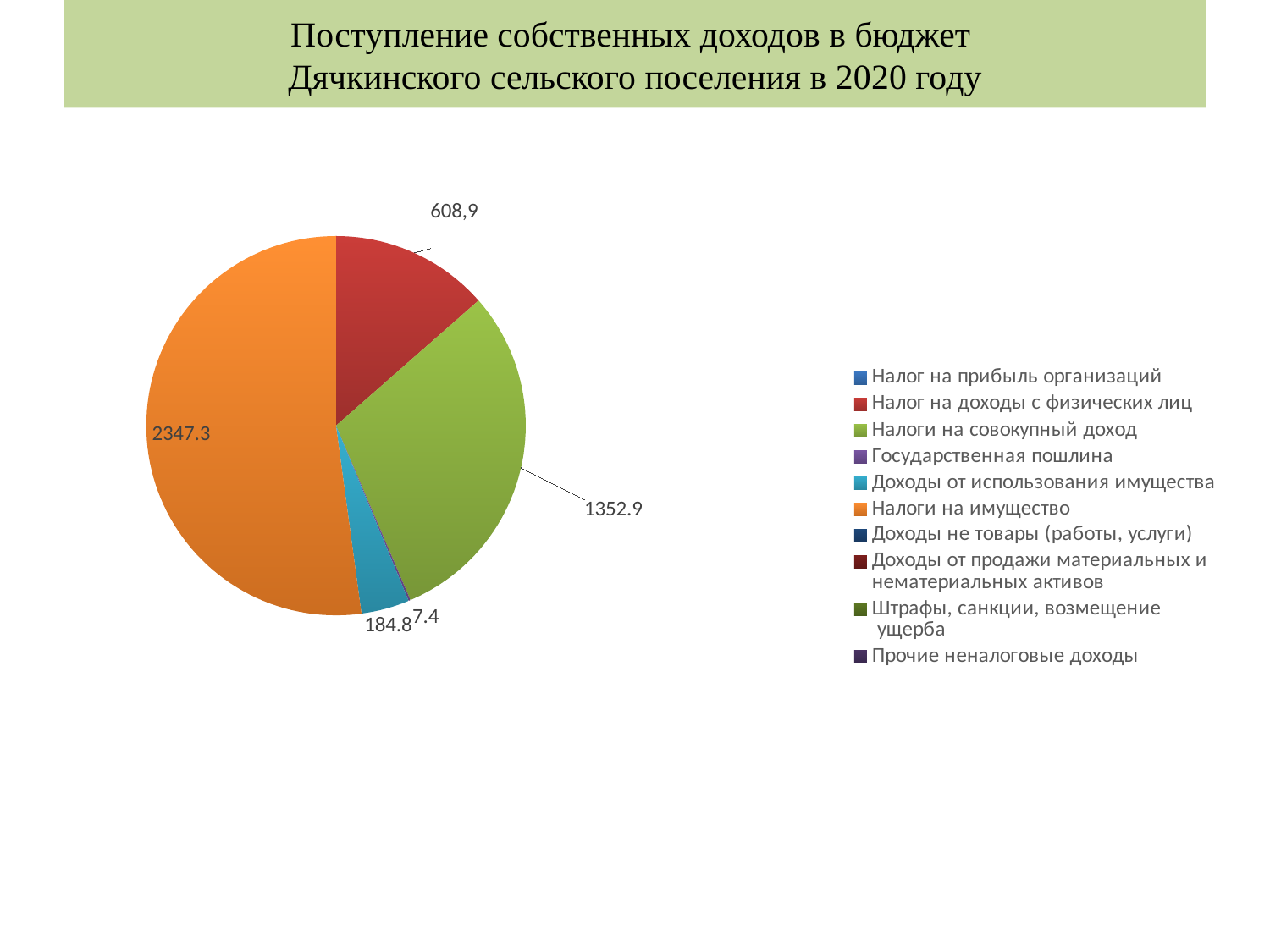
What is the value shown for Налоги на совокупный доход? 1352.9 Which is larger: Налоги на совокупный доход or Налог на доходы с физических лиц? Налоги на совокупный доход What is the value shown for Доходы от использования имущества? 184.8 Which labelled category has the smallest slice of the pie? Государственная пошлина What kind of chart is shown on the slide? pie chart What year does the chart title refer to? 2020 What is the value shown for Государственная пошлина? 7.4 What is the value shown for Налог на доходы с физических лиц? 608,9 How many entries does the legend list? 10 What is the difference between the values for Налоги на имущество and Налоги на совокупный доход? 994.4 What is the value shown for Налоги на имущество? 2347.3 Which category has the largest slice of the pie? Налоги на имущество